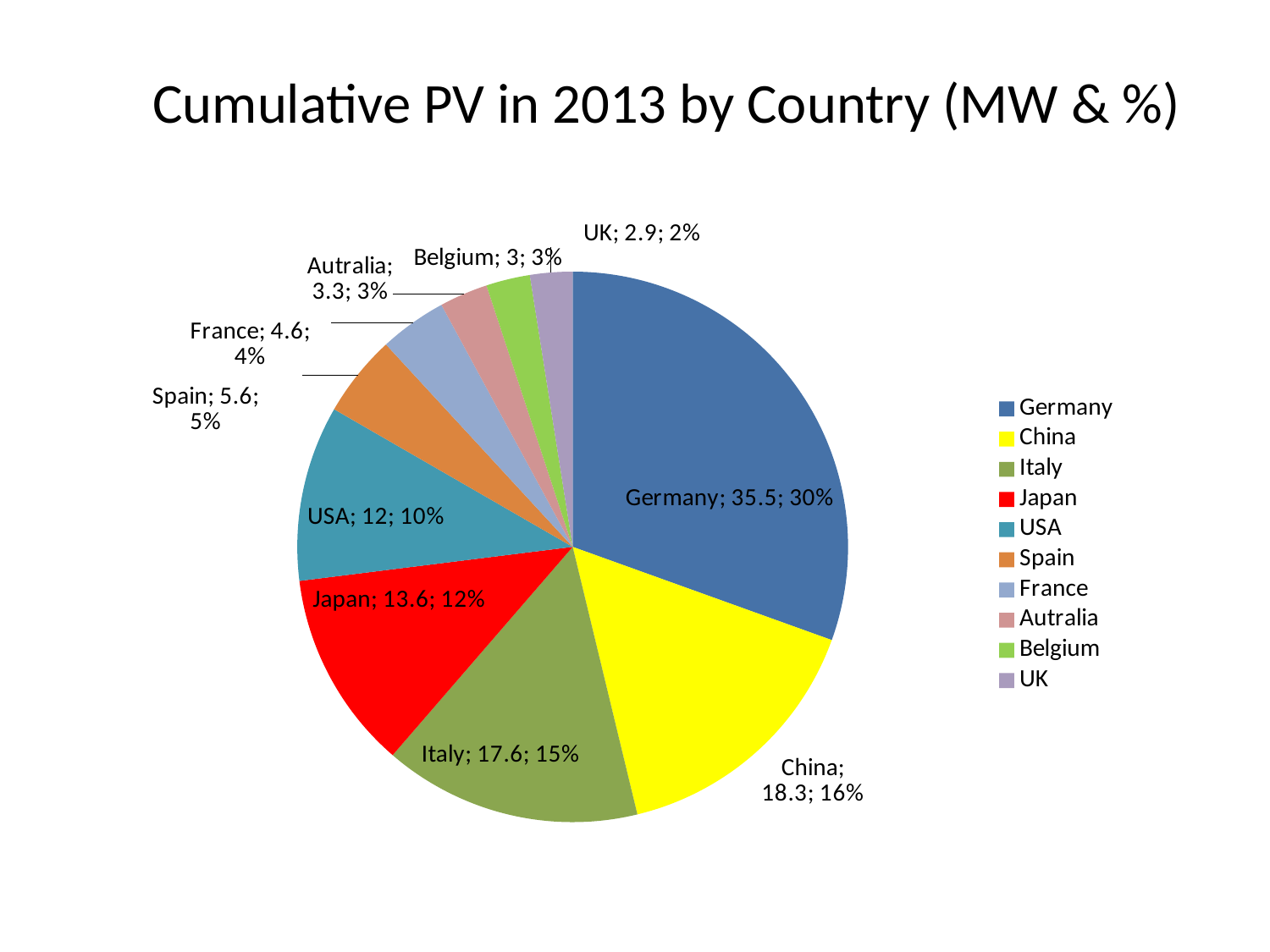
What percentage share does USA have? 10% What is the value for Germany? 35.5 What is the difference between the values for Germany and China? 17.2 How many countries are shown in the pie chart? 10 What is the title of the chart? Cumulative PV in 2013 by Country (MW & %) What percentage share does China have? 16% What colour is the slice for Japan? Red Which country has the smallest slice? UK Which is larger, the value for Italy or the value for Japan? Italy What kind of chart is shown on the slide? Pie chart Which country has the largest slice? Germany What is the value for Japan? 13.6